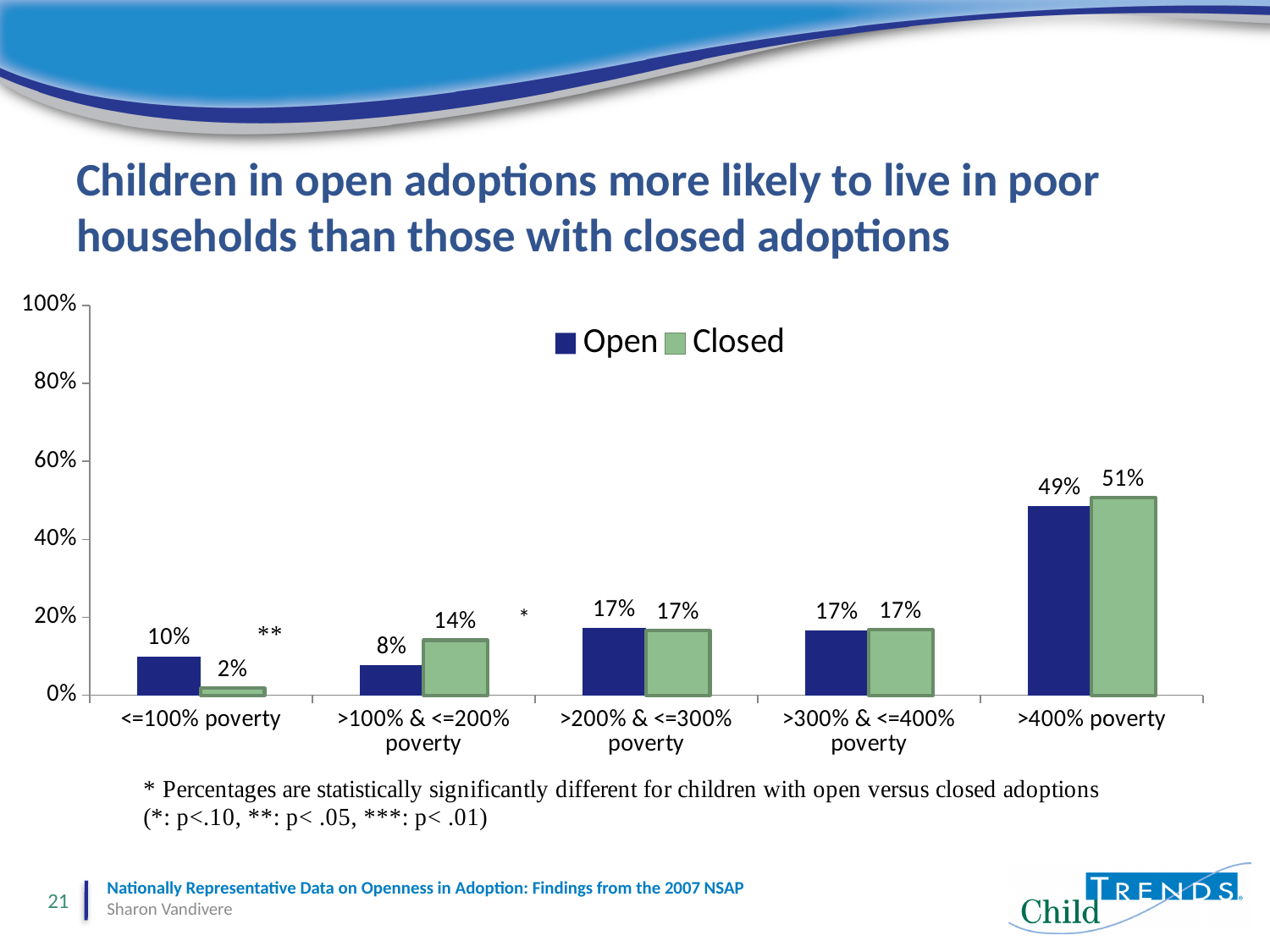
What is the value for Open in the >400% poverty category? 49% Is the value for Closed in the >400% poverty category greater or less than 40%? greater What is the value for Open in the <=100% poverty category? 10% Which category has the highest value for the Closed series? >400% poverty How many poverty categories are shown on the x axis? 5 What is the value for Closed in the >100% & <=200% poverty category? 14% How many series does the legend list? 2 What is the value for Closed in the <=100% poverty category? 2% In the >100% & <=200% poverty category, which series has the larger value, Open or Closed? Closed Which category has the lowest value for the Open series? >100% & <=200% poverty What kind of chart is shown on the slide? bar chart What is the difference between the Open and Closed values in the <=100% poverty category? 8%